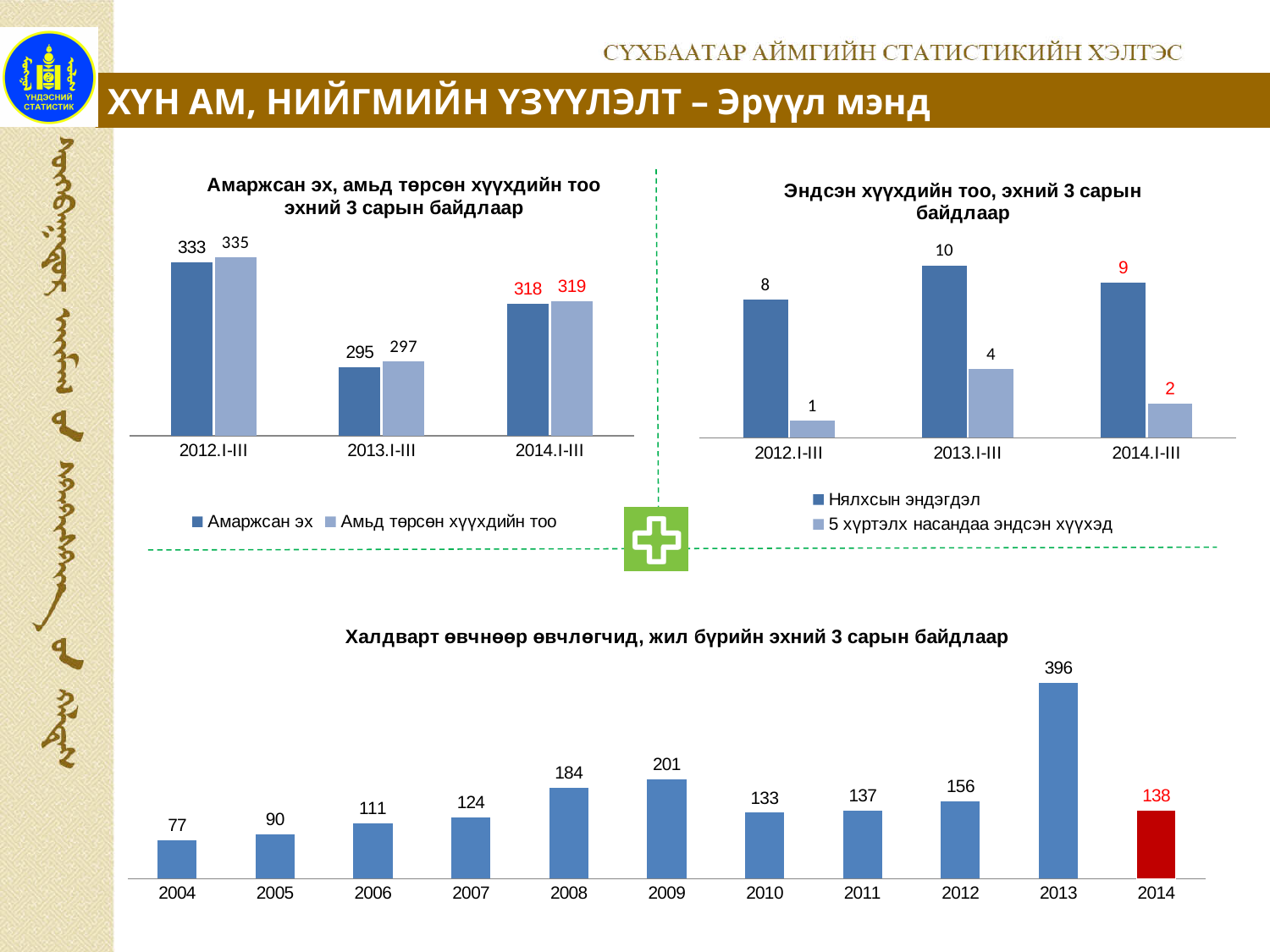
In the top-right chart (Эндсэн хүүхдийн тоо), what is the value for 5 хүртэлх насандаа эндсэн хүүхэд in 2012.I-III? 1 In the bottom chart (Халдварт өвчнөөр өвчлөгчид), what is the difference between the values for 2013 and 2014? 258 In the top-left chart (Амаржсан эх, амьд төрсөн хүүхдийн тоо), what is the value for Амьд төрсөн хүүхдийн тоо in 2014.I-III? 319 In the bottom chart (Халдварт өвчнөөр өвчлөгчид), how many years are shown on the x axis? 11 In the bottom chart (Халдварт өвчнөөр өвчлөгчид), which year has the highest value? 2013 In the top-left chart (Амаржсан эх, амьд төрсөн хүүхдийн тоо), what is the difference between Амаржсан эх in 2012.I-III and 2013.I-III? 38 In the top-left chart (Амаржсан эх, амьд төрсөн хүүхдийн тоо), what is the value for Амаржсан эх in 2013.I-III? 295 In the top-left chart (Амаржсан эх, амьд төрсөн хүүхдийн тоо), how many series does the legend list? 2 In the bottom chart (Халдварт өвчнөөр өвчлөгчид), what is the value for 2009? 201 In the top-right chart (Эндсэн хүүхдийн тоо), what is the value for Нялхсын эндэгдэл in 2013.I-III? 10 In the top-right chart (Эндсэн хүүхдийн тоо), which period has the highest value for 5 хүртэлх насандаа эндсэн хүүхэд? 2013.I-III In the bottom chart (Халдварт өвчнөөр өвчлөгчид), which year has the lowest value? 2004